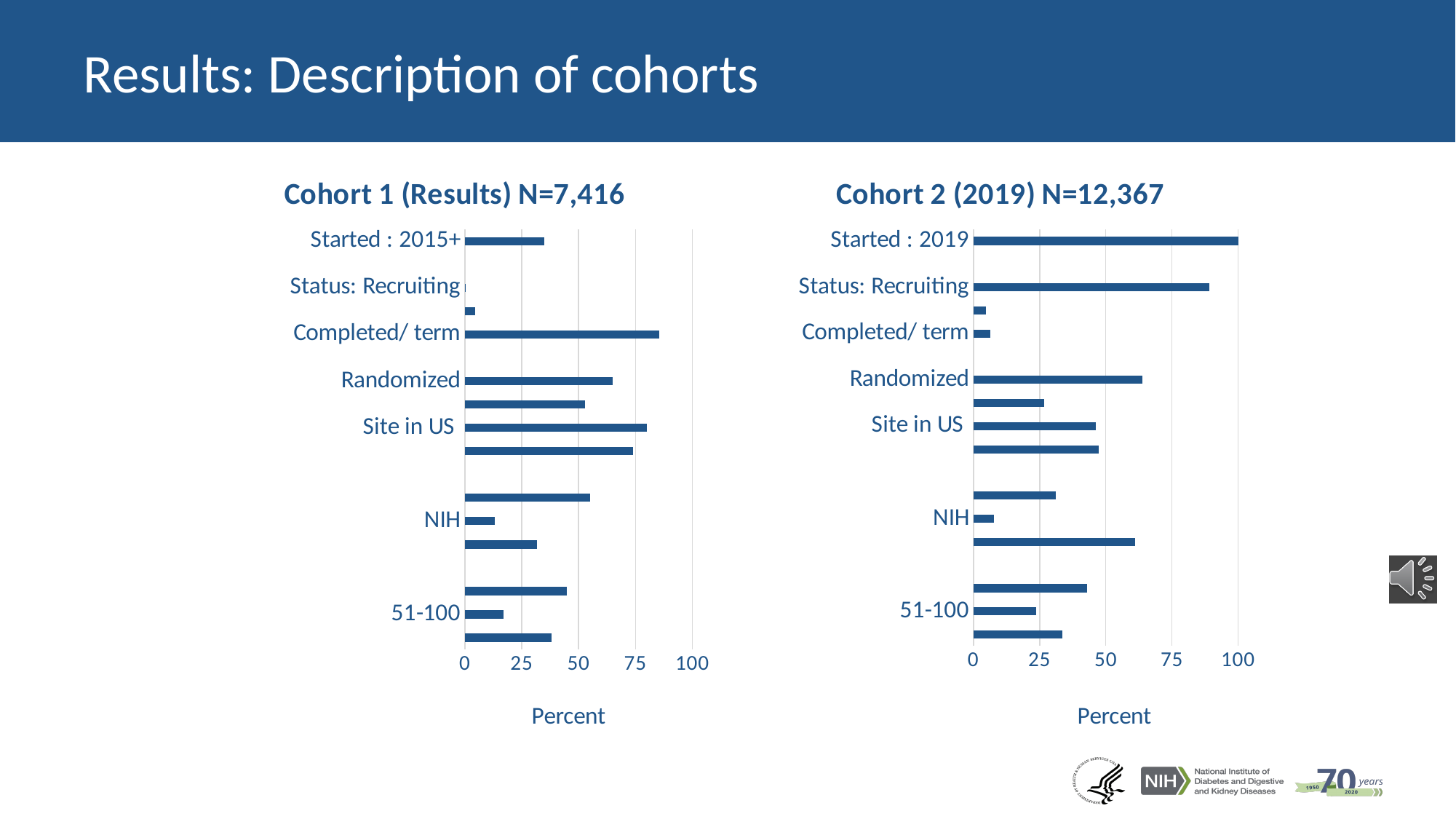
Which cohort chart shows the larger value for Status: Recruiting, Cohort 1 (Results) or Cohort 2 (2019)? Cohort 2 (2019) In the Cohort 1 (Results) chart, is the value for NIH greater or less than 25? less In the Cohort 2 (2019) chart, is the value for Started : 2019 greater or less than 75? greater In the Cohort 2 (2019) chart, is the value for Status: Recruiting greater or less than 75? greater What kind of chart is used for Cohort 1 (Results) N=7,416? bar chart What is the title of the chart on the left of the slide? Cohort 1 (Results) N=7,416 In the Cohort 1 (Results) chart, which is larger, Site in US or Randomized? Site in US What is the x-axis label on the Cohort 2 (2019) chart? Percent In the Cohort 2 (2019) chart, which is larger, Randomized or Site in US? Randomized